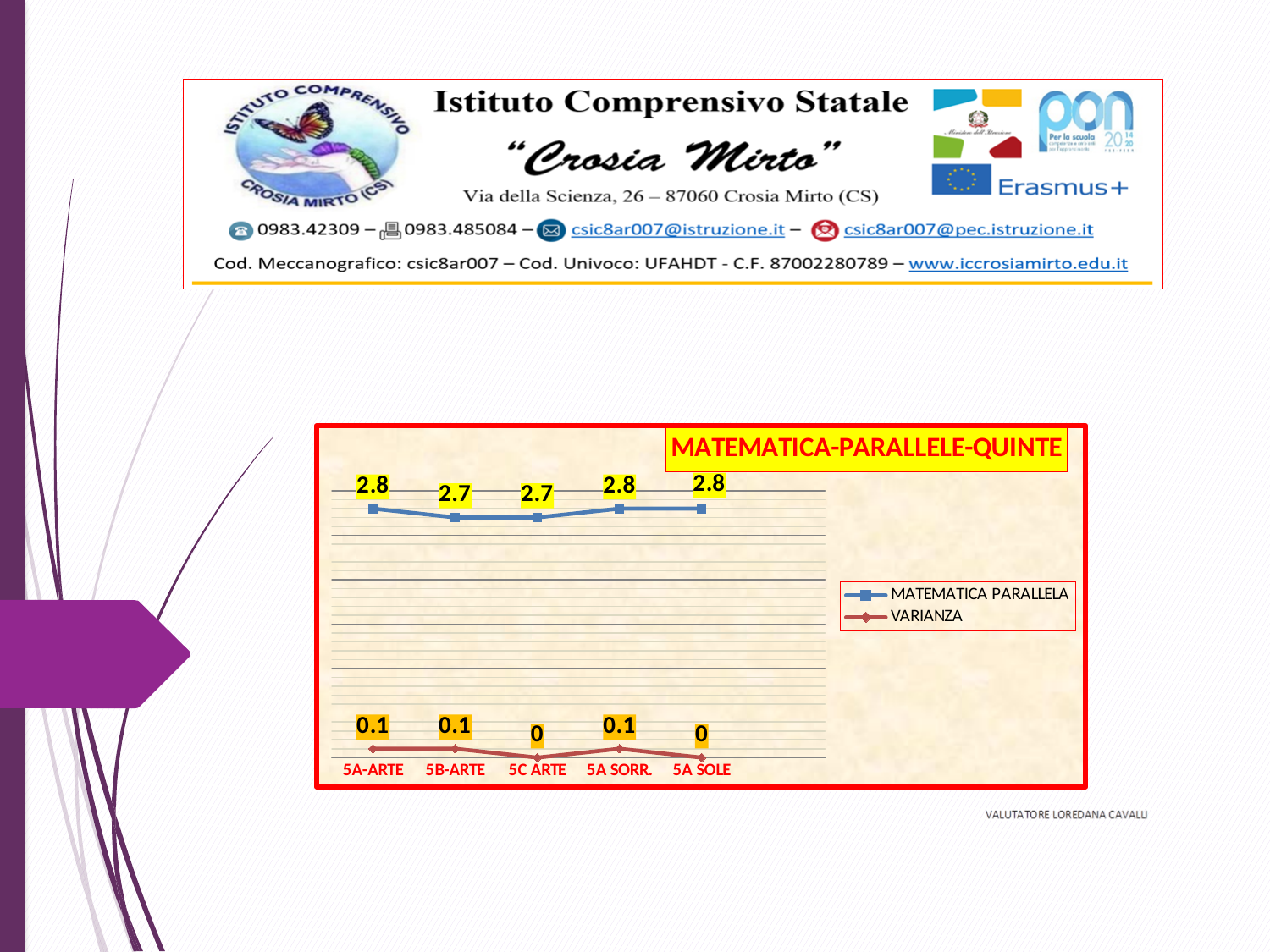
What is the MATEMATICA PARALLELA value for 5A SOLE? 2.8 What is the VARIANZA value for 5A SORR.? 0.1 What is the MATEMATICA PARALLELA value for 5A-ARTE? 2.8 What is the difference between the MATEMATICA PARALLELA values for 5A-ARTE and 5B-ARTE? 0.1 What is the title of the chart? MATEMATICA-PARALLELE-QUINTE What is the MATEMATICA PARALLELA value for 5B-ARTE? 2.7 How many classes are shown on the x axis of the chart? 5 What is the MATEMATICA PARALLELA value for 5C ARTE? 2.7 What kind of chart is shown on the slide? Line chart What is the VARIANZA value for 5C ARTE? 0 Which has the larger MATEMATICA PARALLELA value, 5A SORR. or 5C ARTE? 5A SORR. How many series does the legend list? 2